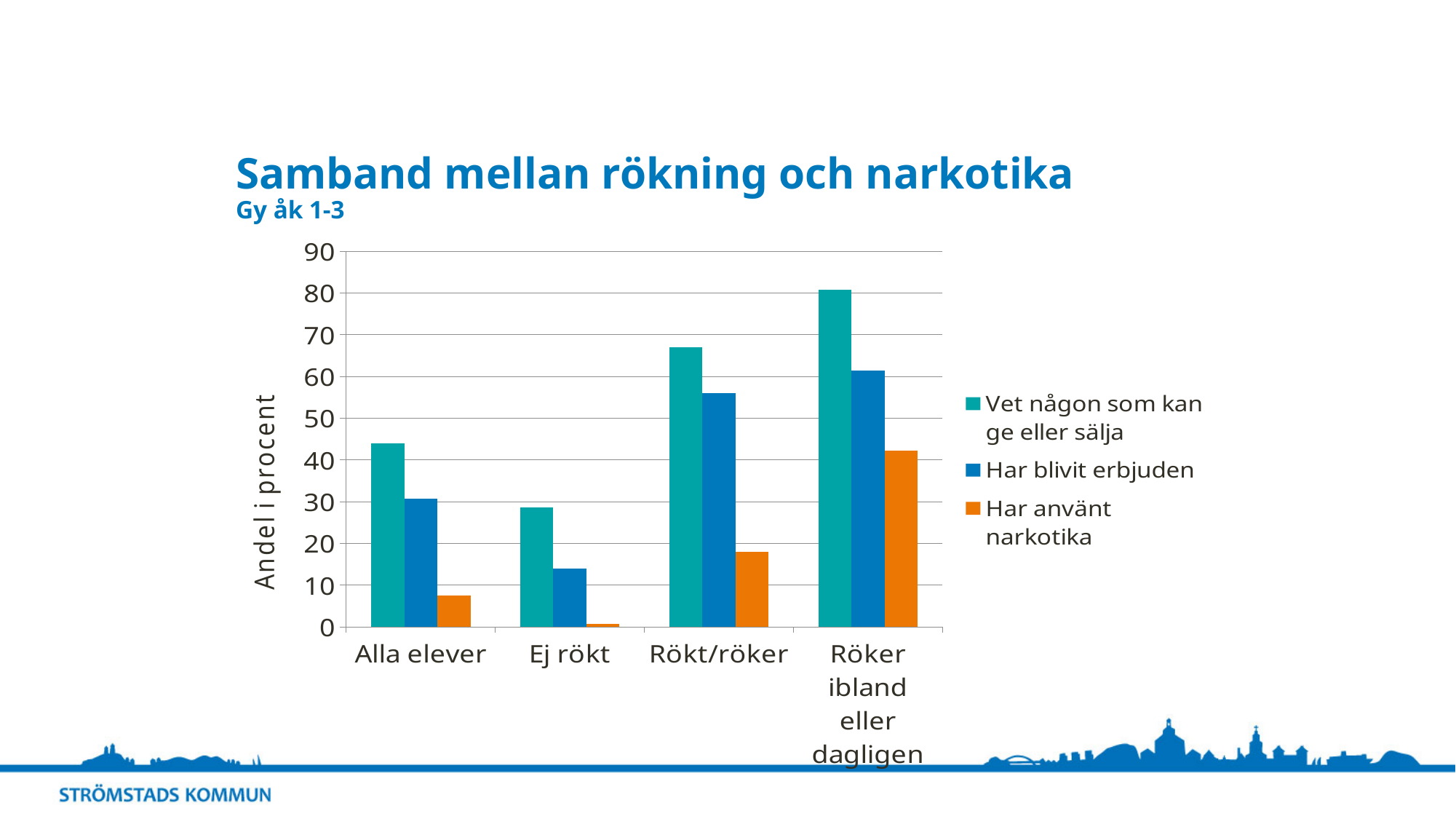
What is the label of the y axis? Andel i procent Which is larger: 'Har använt narkotika' for 'Röker ibland eller dagligen' or 'Vet någon som kan ge eller sälja' for 'Ej rökt'? Har använt narkotika for Röker ibland eller dagligen Which is larger: 'Har blivit erbjuden' for 'Rökt/röker' or 'Har blivit erbjuden' for 'Ej rökt'? Rökt/röker Is the value for 'Har blivit erbjuden' in the 'Alla elever' category greater or less than 40? less How many categories are shown on the x axis? 4 What kind of chart is shown on the slide? bar chart Which category has the highest value for 'Vet någon som kan ge eller sälja'? Röker ibland eller dagligen Is the value for 'Har använt narkotika' in the 'Rökt/röker' category greater or less than 10? greater How many series does the legend list? 3 What is the title of the chart on the slide? Samband mellan rökning och narkotika Which category has the lowest value for 'Har använt narkotika'? Ej rökt